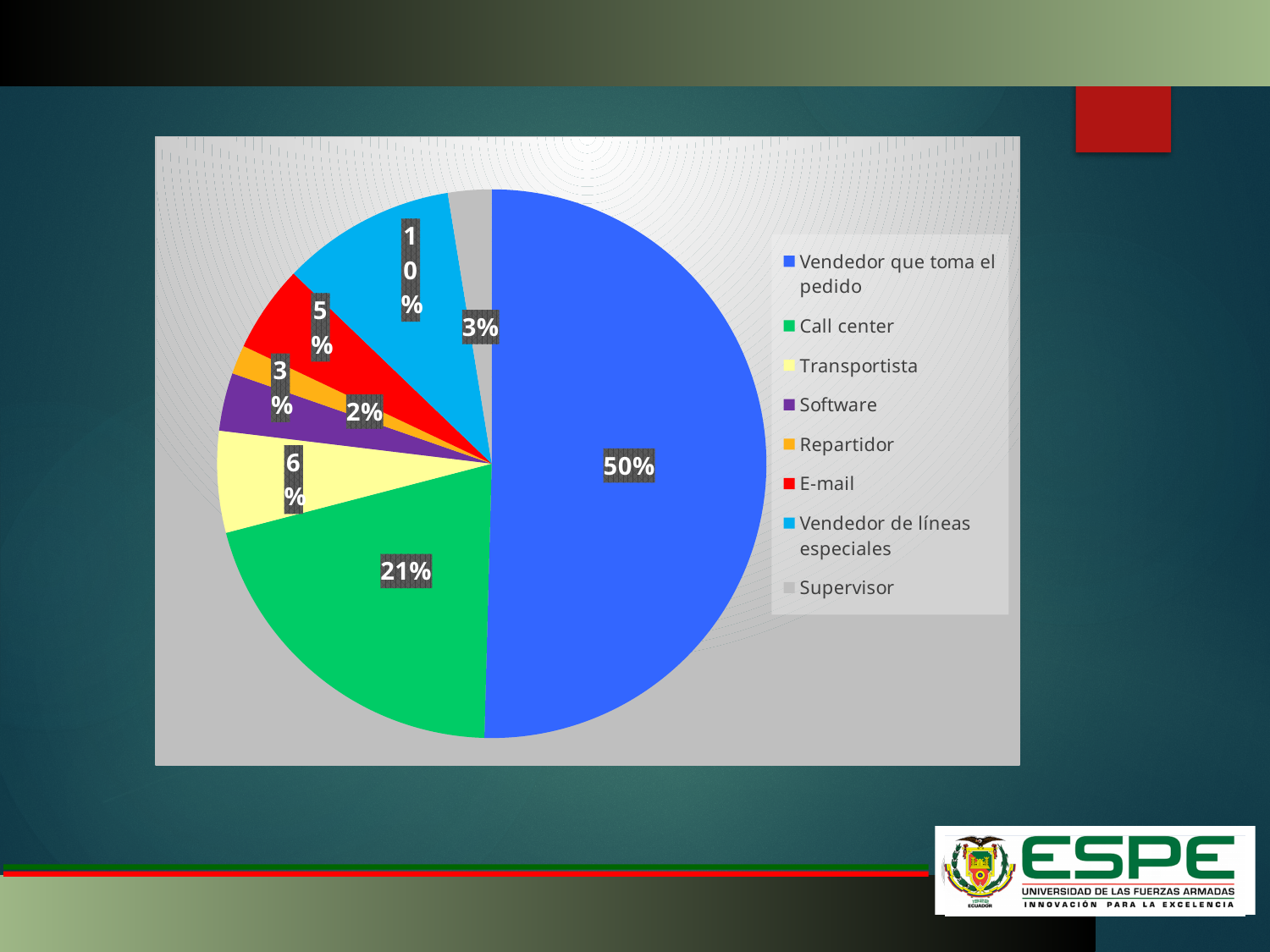
What percentage is shown for E-mail? 5% What share of the pie does Vendedor que toma el pedido have? 50% Which is larger, the share for Transportista or the share for E-mail? Transportista What percentage is shown for Vendedor de líneas especiales? 10% What percentage is shown for Call center? 21% Which category has the largest slice of the pie? Vendedor que toma el pedido What is the difference in percentage points between Vendedor que toma el pedido and Call center? 29 What percentage is shown for Transportista? 6% Which category has the smallest slice of the pie? Repartidor What colour is the slice for Call center? Green How many categories does the pie chart show? 8 What kind of chart is shown on the slide? Pie chart